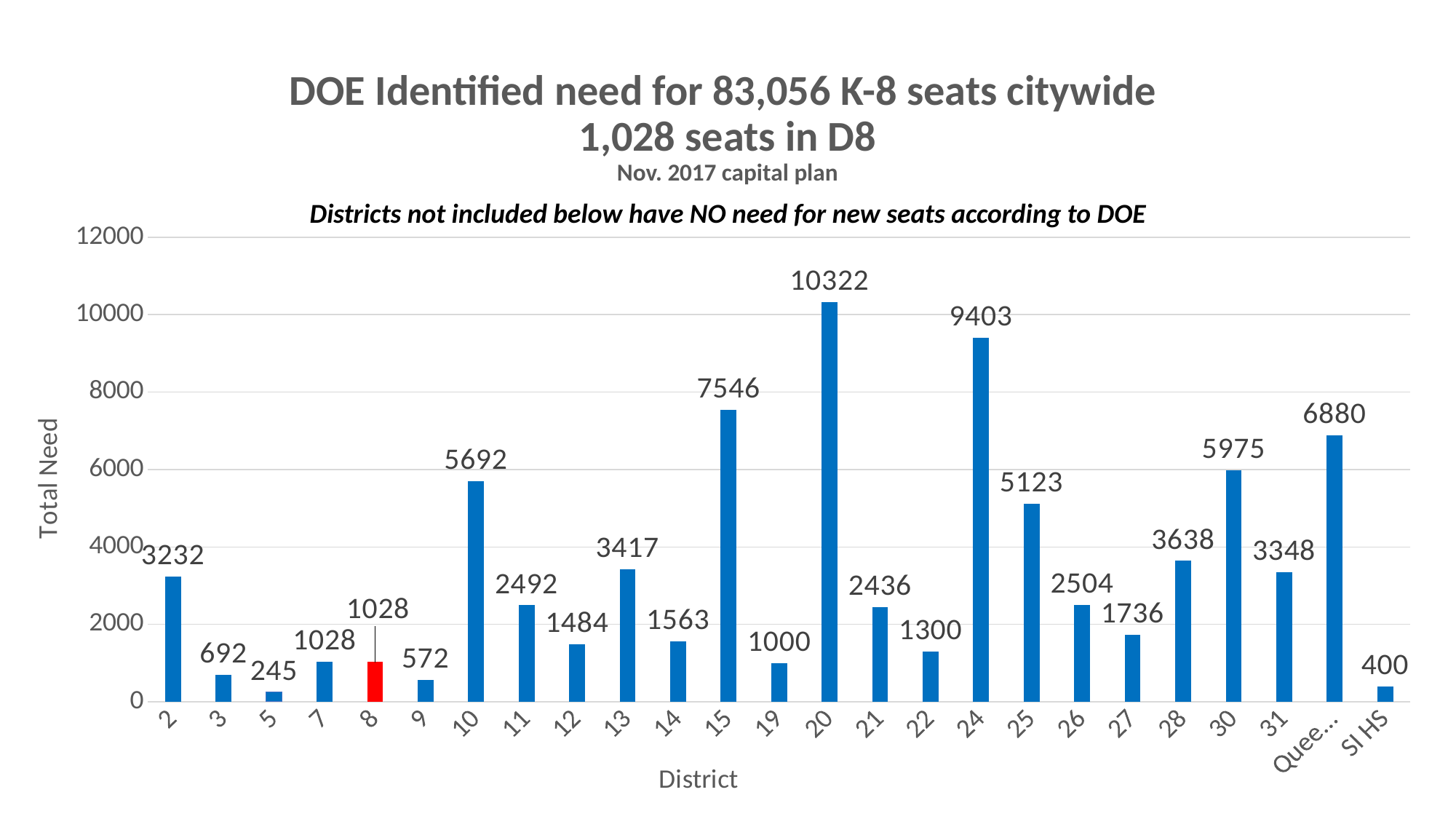
What is the total need value for district 8? 1028 Is the value for district 25 greater or less than 6000? less What is the total need value for district 15? 7546 Which has a larger total need, district 10 or district 30? District 30 Which district's bar is coloured red instead of blue? 8 What type of chart is shown on the slide? Bar chart What is the difference between the total need for district 20 and district 24? 919 Which district has the highest total need? 20 Which district has the lowest total need? 5 What is the total need value for SI HS? 400 How many districts (bars) are shown in the chart? 25 What is the total need value for district 20? 10322